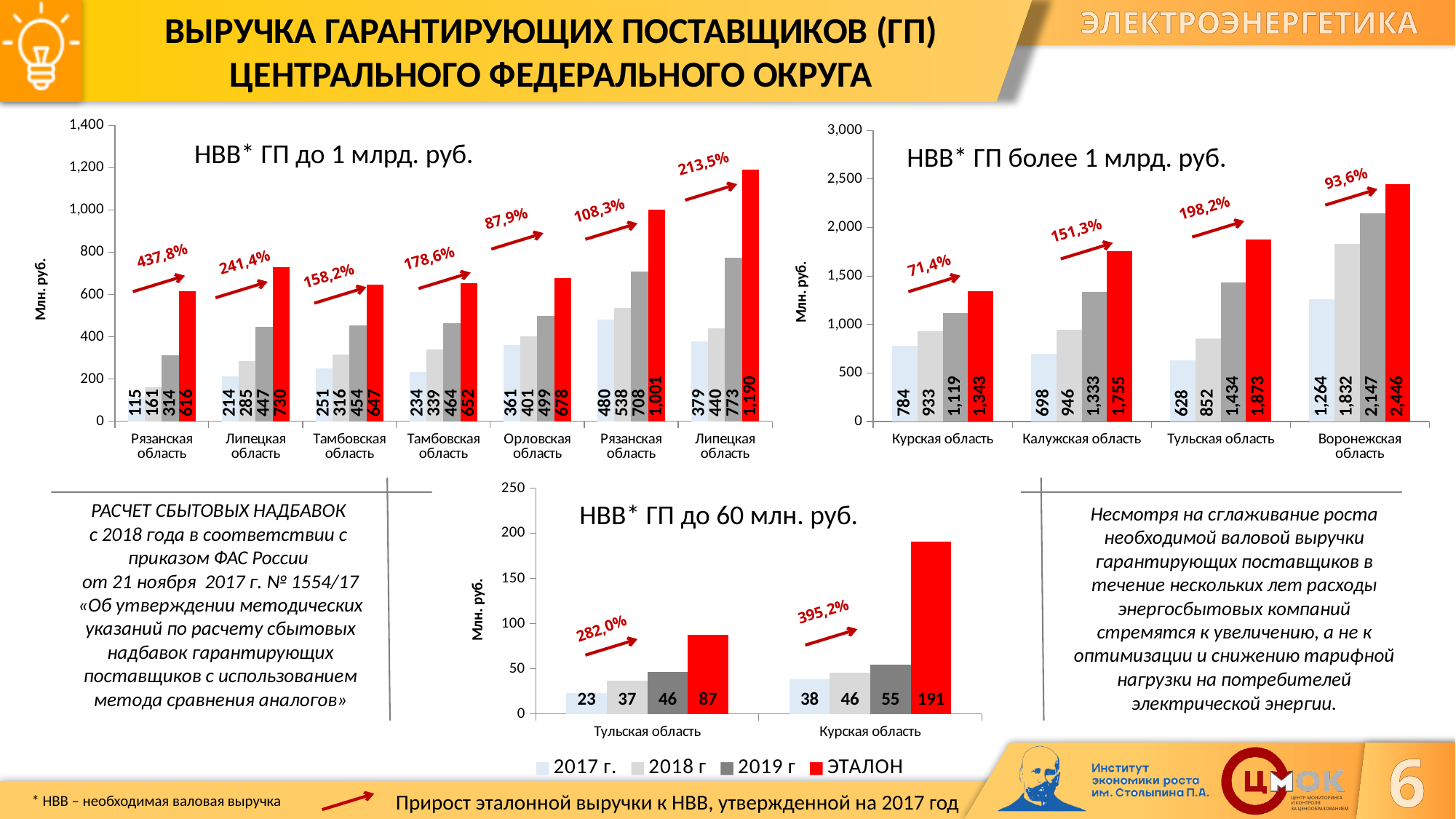
In the chart titled "НВВ* ГП более 1 млрд. руб.", which has the larger 2018 г value: Калужская область or Курская область? Калужская область In the chart titled "НВВ* ГП до 60 млн. руб.", do the values for Тульская область rise or fall from 2017 г. through to ЭТАЛОН? rise How many regions are shown in the chart titled "НВВ* ГП более 1 млрд. руб."? 4 In the chart titled "НВВ* ГП более 1 млрд. руб.", what growth percentage is shown above Воронежская область? 93,6% In the chart titled "НВВ* ГП более 1 млрд. руб.", which region has the lowest 2017 г. value? Тульская область In the chart titled "НВВ* ГП более 1 млрд. руб.", what is the ЭТАЛОН value for Воронежская область? 2,446 What kind of chart is the chart titled "НВВ* ГП до 60 млн. руб."? bar chart How many series does the legend at the bottom of the slide list? 4 In the chart titled "НВВ* ГП до 60 млн. руб.", what is the 2017 г. value for Курская область? 38 In the chart titled "НВВ* ГП до 1 млрд. руб.", what is the 2019 г value for Орловская область? 499 In the chart titled "НВВ* ГП более 1 млрд. руб.", which region has the highest ЭТАЛОН value? Воронежская область In the chart titled "НВВ* ГП до 60 млн. руб.", what is the difference between the ЭТАЛОН values for Курская область and Тульская область? 104